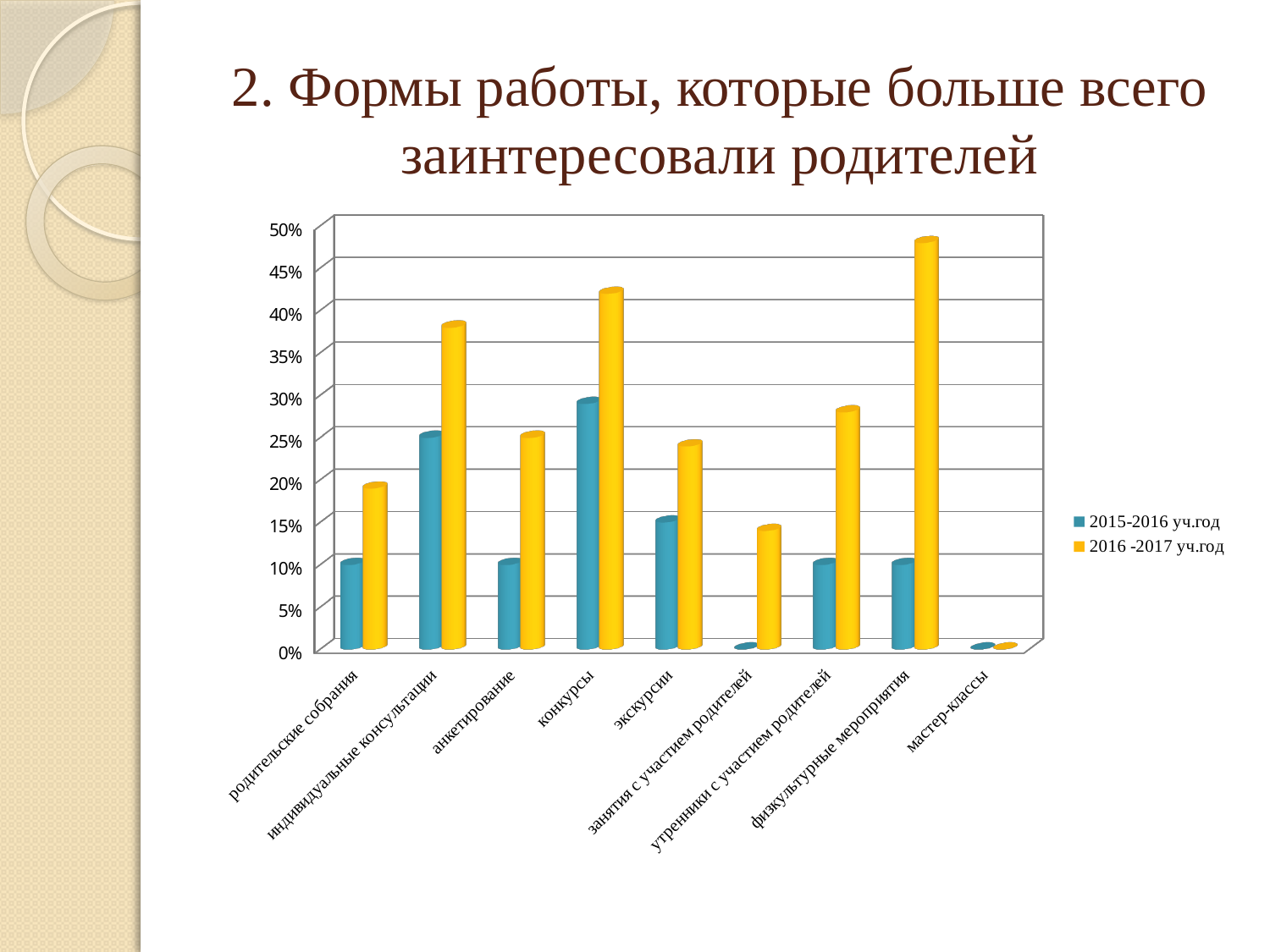
How many series does the legend list? 2 How many categories are shown on the x axis? 9 Which category has a larger 2016 -2017 уч.год value: экскурсии or занятия с участием родителей? экскурсии Is the 2016 -2017 уч.год value for физкультурные мероприятия greater or less than 45%? greater Is the 2015-2016 уч.год value for родительские собрания greater or less than 15%? less Which is larger for конкурсы: the 2015-2016 уч.год value or the 2016 -2017 уч.год value? 2016 -2017 уч.год Which colour represents the 2016 -2017 уч.год series? yellow Which category has the highest value for the 2015-2016 уч.год series? конкурсы What kind of chart is shown on the slide? bar chart Is the 2016 -2017 уч.год value for индивидуальные консультации greater or less than 35%? greater Which category has the highest value for the 2016 -2017 уч.год series? физкультурные мероприятия Which category has the lowest value for the 2016 -2017 уч.год series? мастер-классы